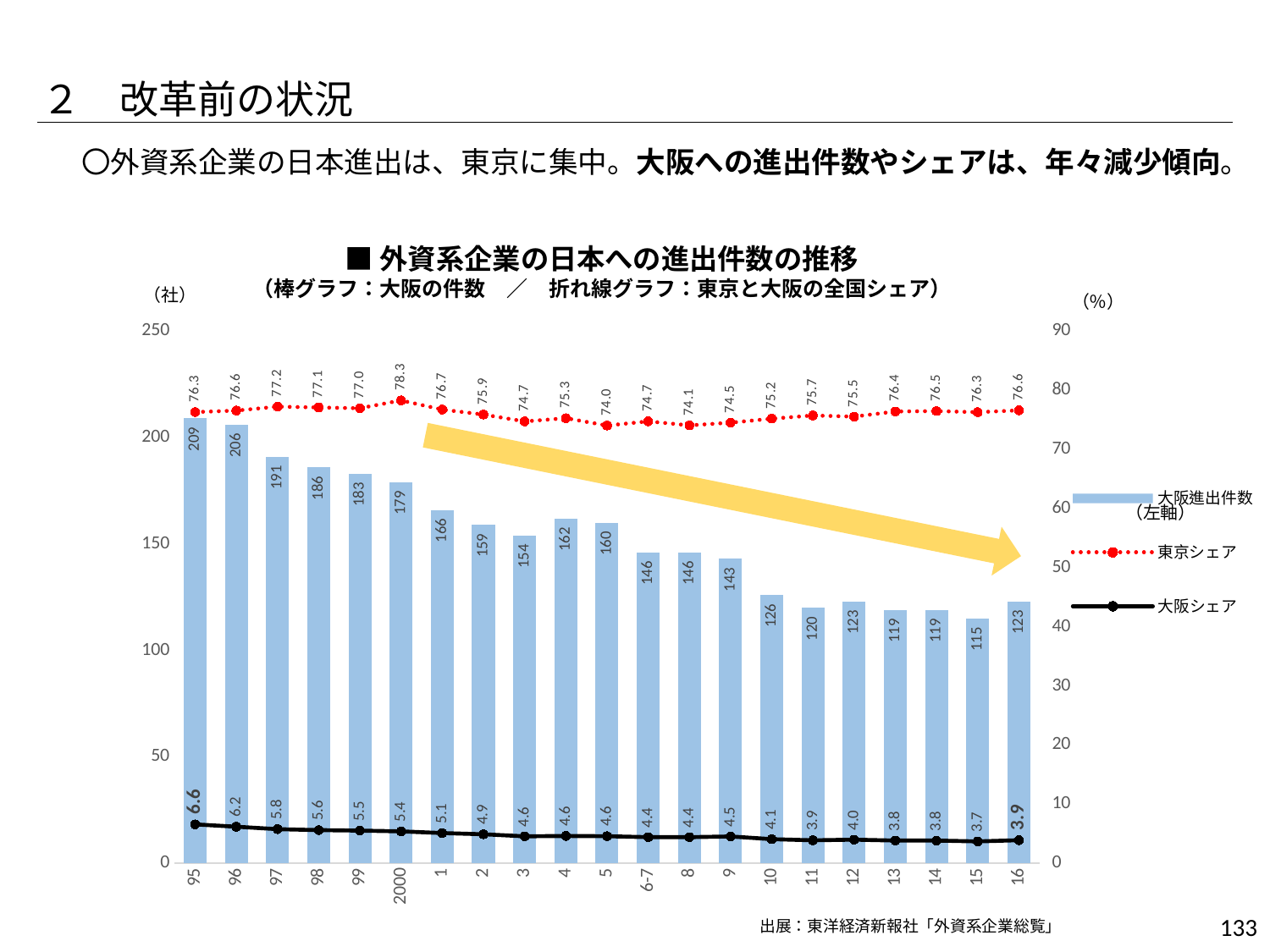
Which year has the highest 大阪進出件数? 95 How many years (categories) are shown on the x axis? 21 Which year has the lowest 大阪進出件数? 15 What is the difference between the 大阪進出件数 for 95 and for 16? 86 How many series does the legend list? 3 In which year is the 大阪シェア lowest? 15 In which year is the 東京シェア highest? 2000 What is the 東京シェア value for 2000? 78.3 What kind of chart is this? Combined bar and line chart What is the 大阪シェア value for 16? 3.9 What is the 大阪進出件数 value for 95? 209 Which has the larger 大阪進出件数, year 3 or year 4? 4